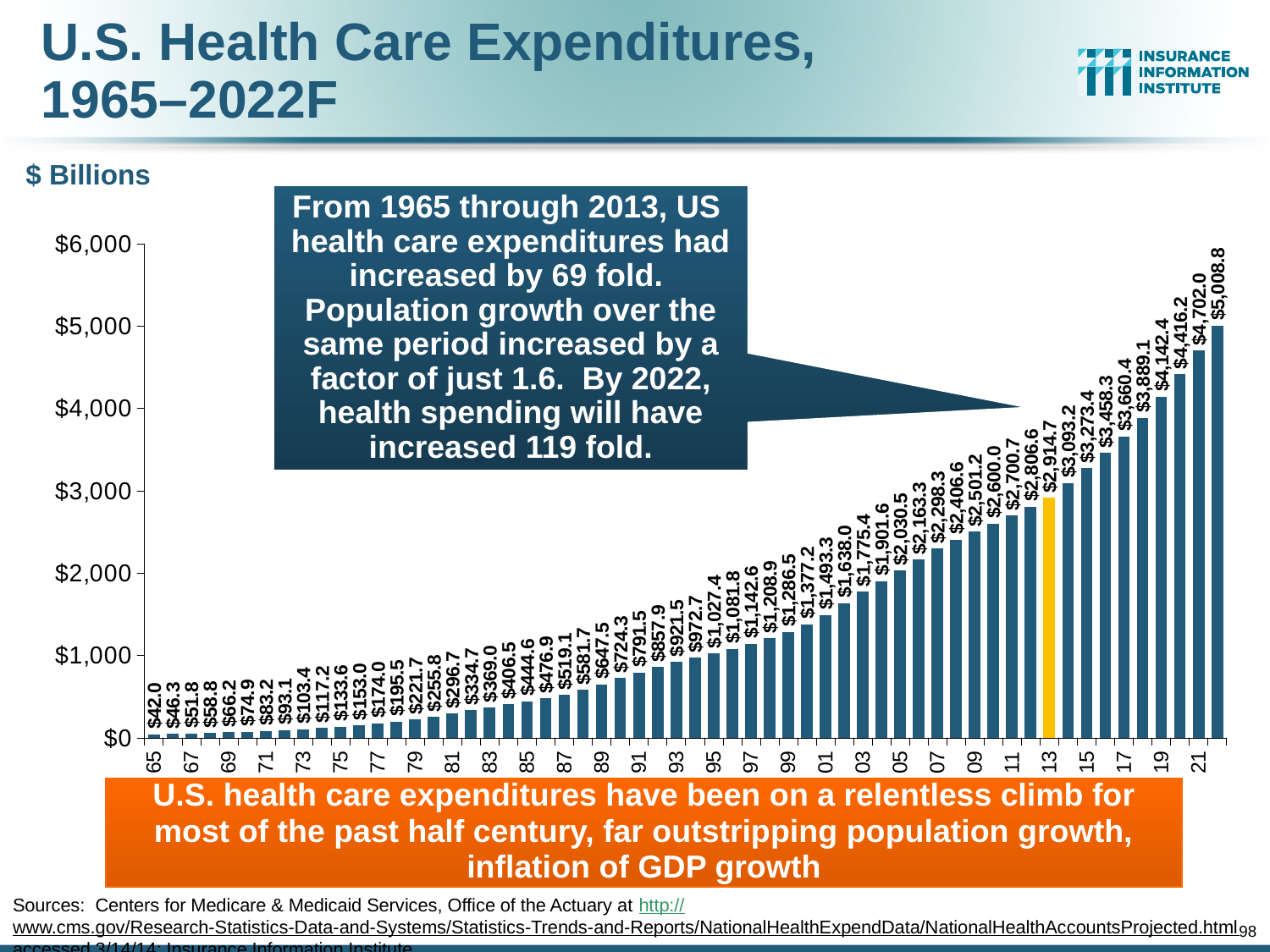
How many years (bars) are plotted in the chart? 58 Which year has the lowest expenditure? 1965 (65) Is the value for 2010 greater or less than $2,000? greater Which is larger, the value for 1990 or the value for 2000? 2000 What is the value for 1965? $42.0 Do the values rise or fall from 1965 to 2022? Rise What is the difference between the 2022 value and the 2013 value? $2,094.1 Which year has the highest expenditure? 2022 (22) What kind of chart is shown? Bar chart What unit is shown for the y axis? $ Billions What is the value for 2000? $1,377.2 What is the value for 2013 (the highlighted bar)? $2,914.7